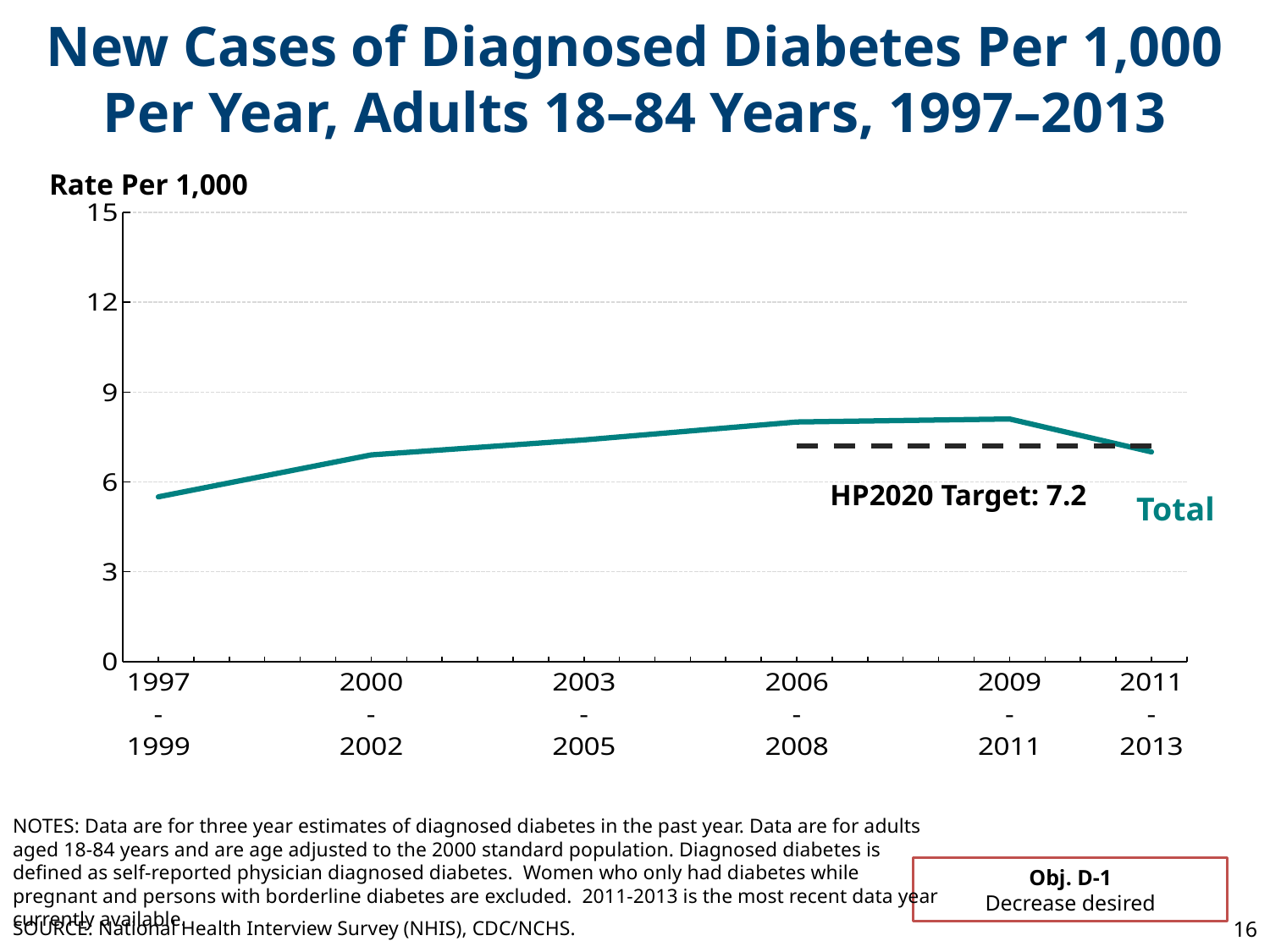
Is the value for 2009-2011 greater or less than 9? less Which time period has the lowest rate of new cases of diagnosed diabetes? 1997-1999 Is the value for 2006-2008 greater or less than 6? greater Is the value for 1997-1999 greater or less than 6? less Which is larger, the value for 1997-1999 or the value for 2006-2008? 2006-2008 What is the HP2020 Target value shown on the chart? 7.2 Does the rate rise or fall from 1997-1999 to 2009-2011? rise What is the name of the plotted series? Total What kind of chart is shown on the slide? line chart What is the label on the y axis of the chart? Rate Per 1,000 How many time periods are plotted along the x axis? 6 Does the rate rise or fall from 2009-2011 to 2011-2013? fall